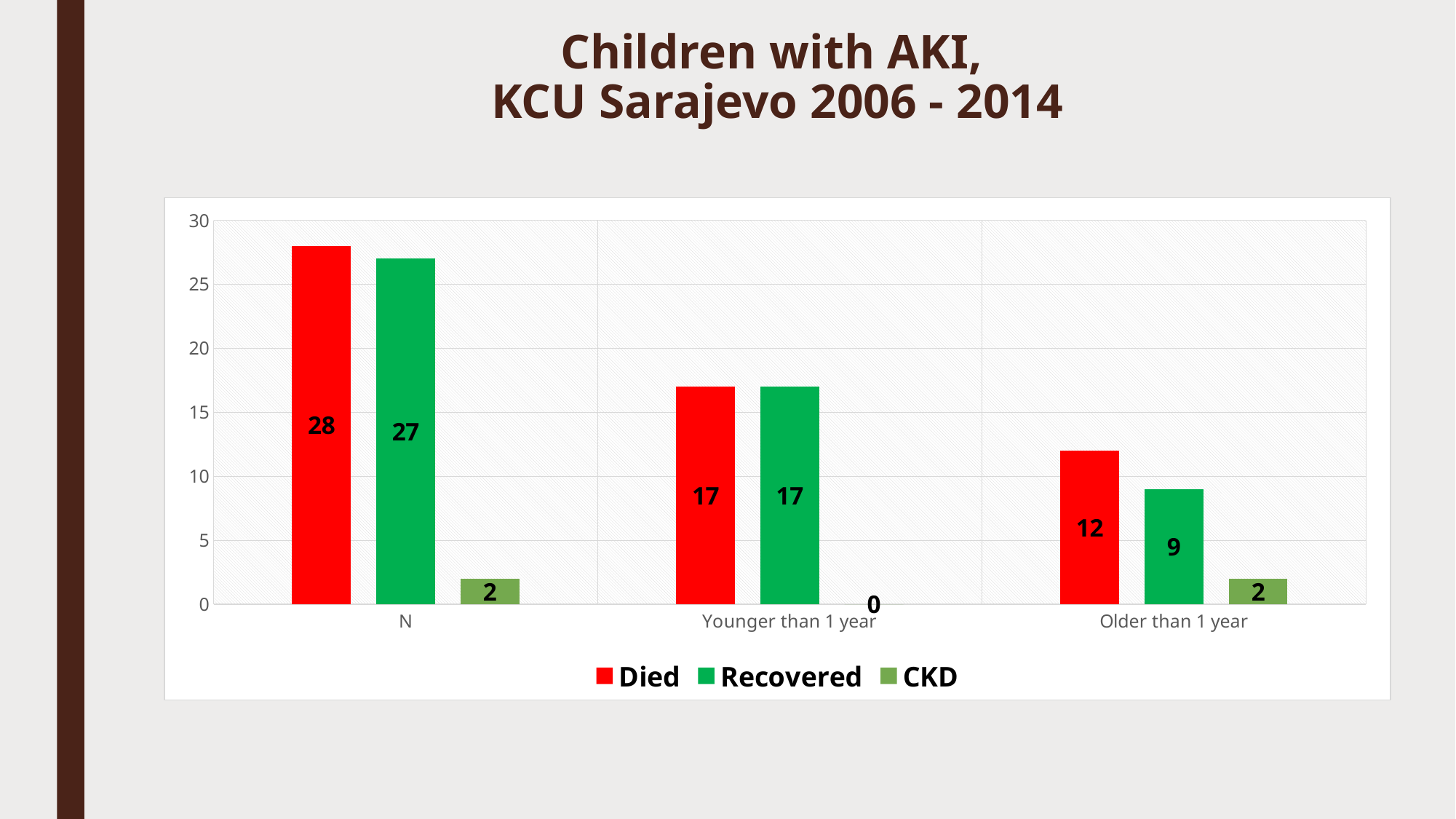
What is the title of the slide? Children with AKI, KCU Sarajevo 2006 - 2014 How many series does the legend list? 3 What kind of chart is shown on the slide? Bar chart What is the difference between Died and Recovered in the Older than 1 year category? 3 What is the value for Died in the Younger than 1 year category? 17 How many categories are shown on the x axis? 3 Which category has the highest value for Died? N Which category has the lowest value for Recovered? Older than 1 year What is the value for Recovered in the Older than 1 year category? 9 Which is larger in the N category, Died or Recovered? Died What is the value for CKD in the Younger than 1 year category? 0 What is the value for Died in the N category? 28